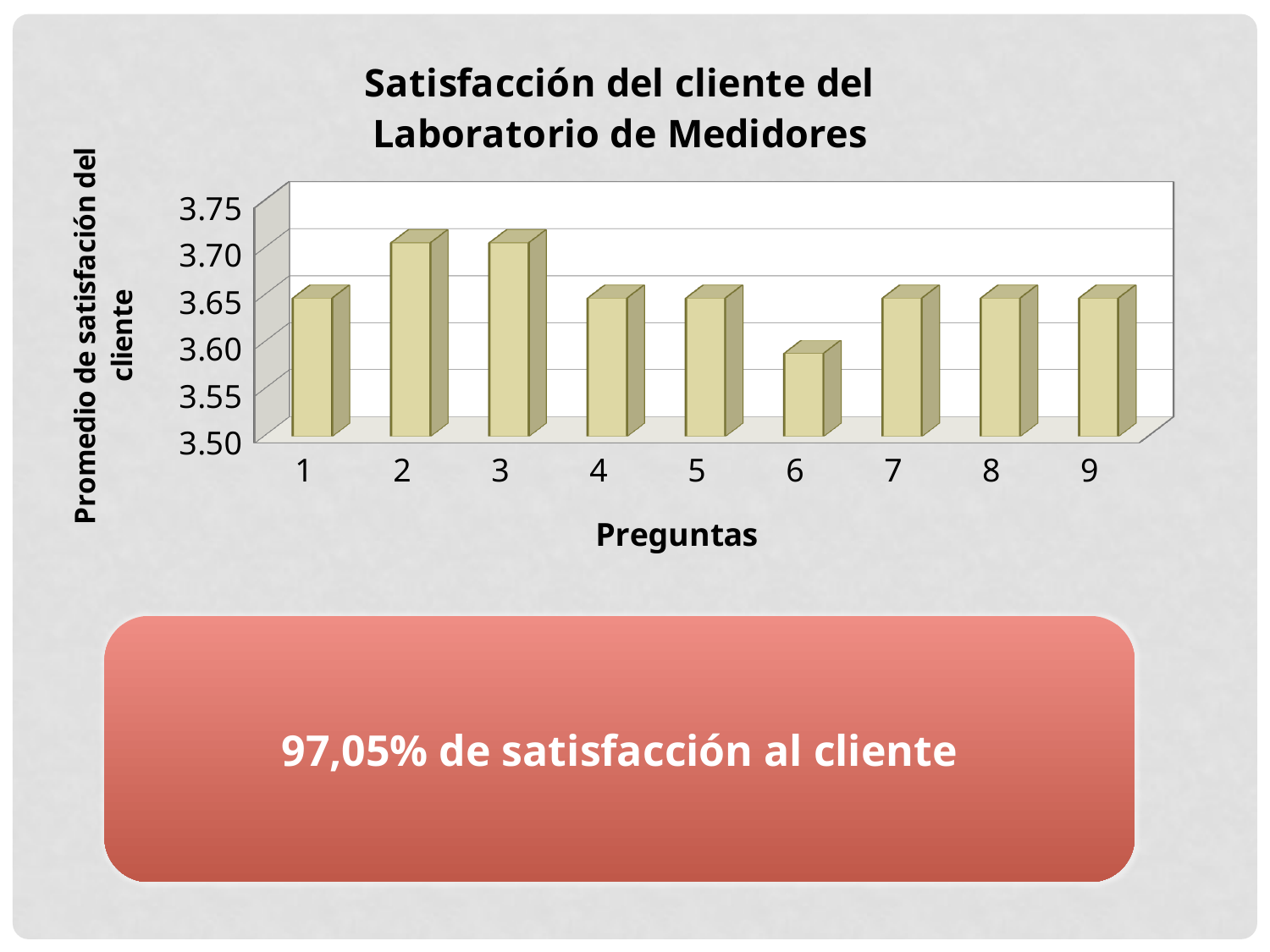
What kind of chart is shown on the slide? bar chart What is the label of the x axis of the chart? Preguntas Is the value for pregunta 2 greater or less than 3.65? greater Is the value for pregunta 6 greater or less than 3.65? less Is the value for pregunta 1 greater or less than 3.70? less Which pregunta has the lowest average satisfaction in the chart? 6 What is the title of the chart? Satisfacción del cliente del Laboratorio de Medidores Which has a higher average satisfaction, pregunta 3 or pregunta 4? 3 Which has a higher average satisfaction, pregunta 2 or pregunta 6? 2 Which has a higher average satisfaction, pregunta 1 or pregunta 6? 1 How many questions (preguntas) are plotted on the x axis of the chart? 9